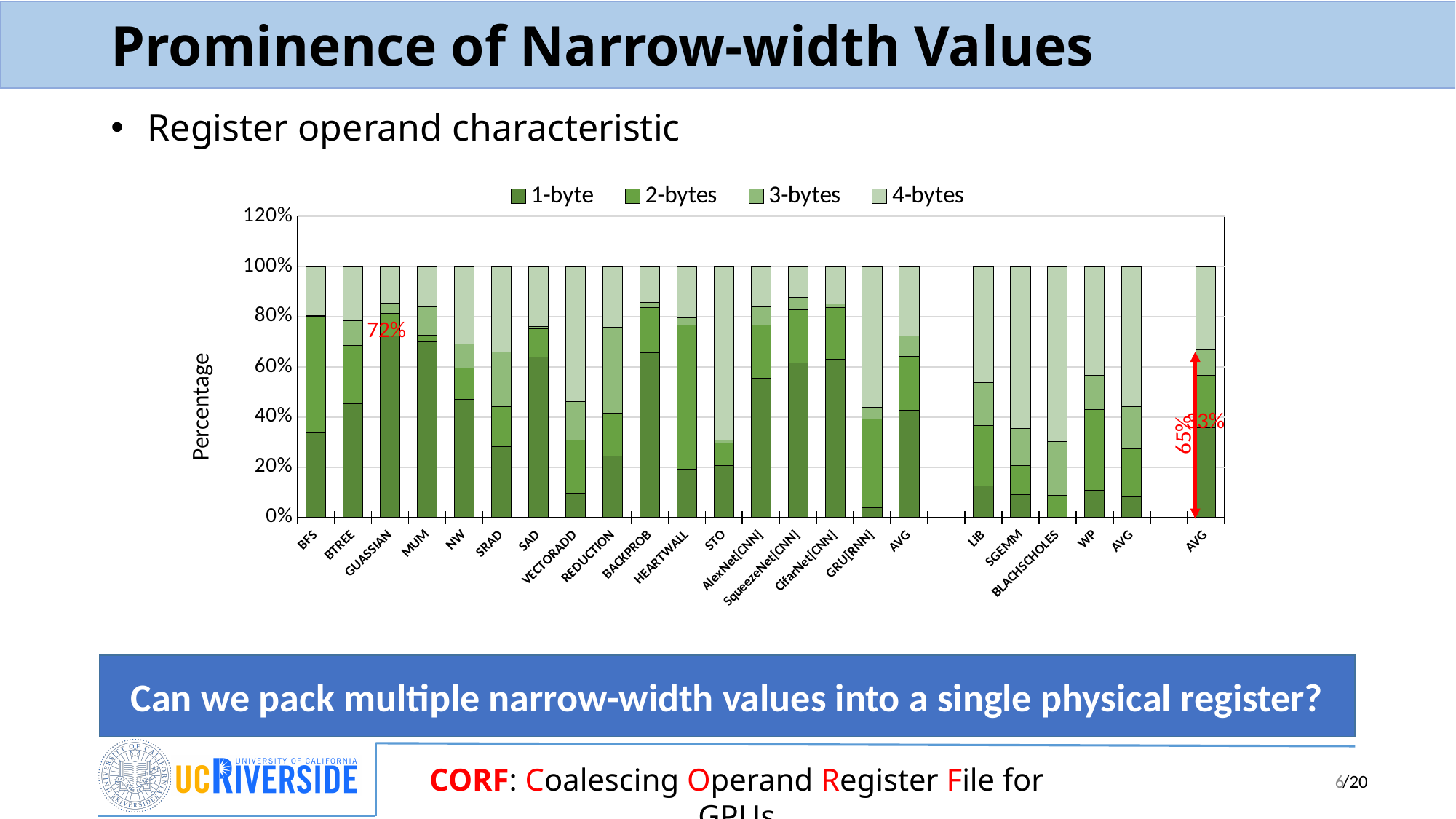
How many bars (categories) are plotted on the x-axis of the chart? 23 Is the 1-byte value for VECTORADD greater or less than 20%? less How many series does the chart legend list? 4 What is the label on the y-axis of the chart? Percentage Is the 1-byte value for GUASSIAN greater or less than 60%? greater What is the total height of each stacked bar in the chart? 100% What type of chart is shown on the slide? Stacked bar chart Which category has the largest 1-byte segment? GUASSIAN What are the series names listed in the chart legend? 1-byte, 2-bytes, 3-bytes, 4-bytes What percentage is annotated in red next to the GUASSIAN bar? 72% Which category has the smallest 1-byte segment? BLACHSCHOLES